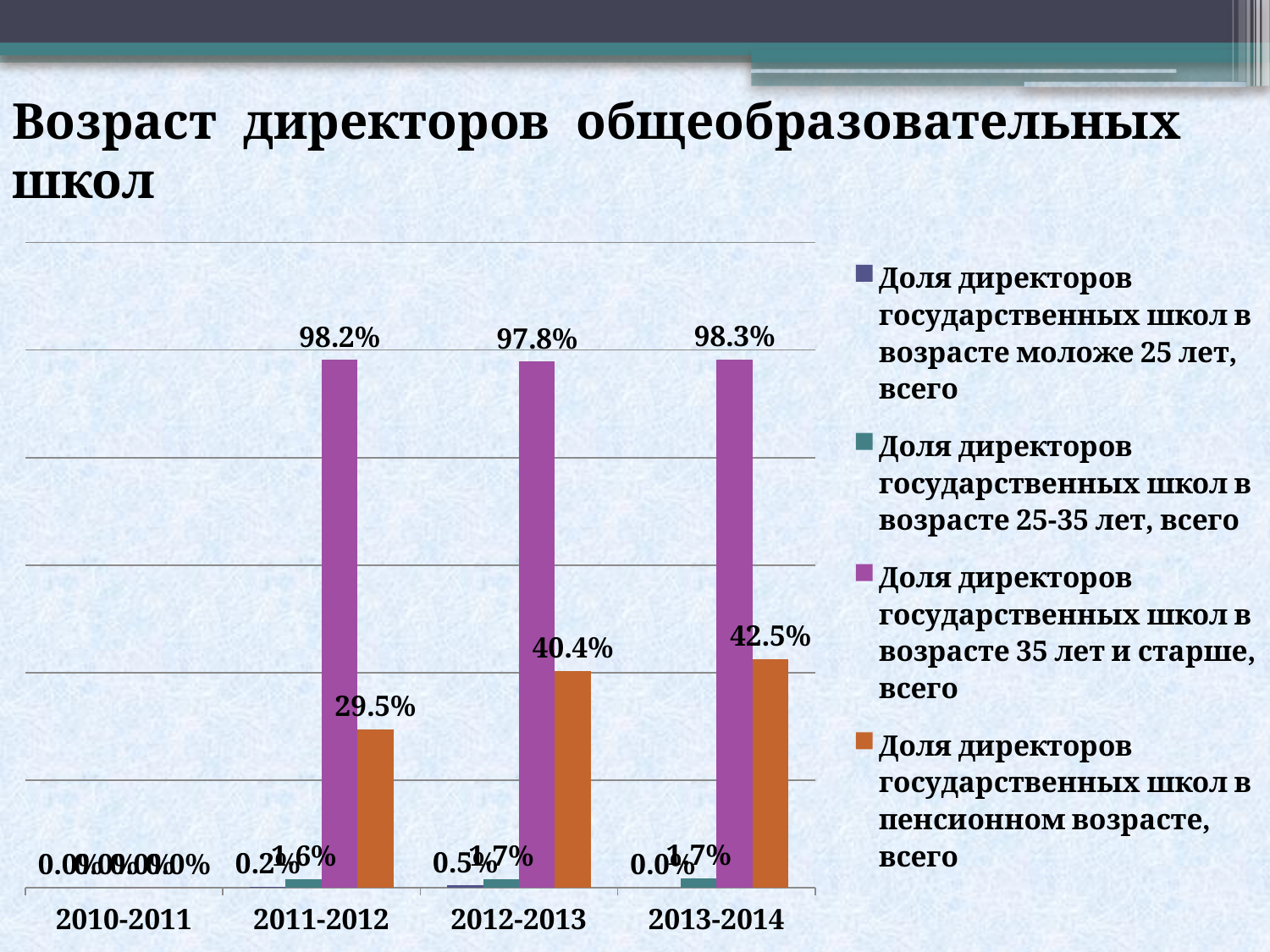
How many year categories are shown on the x axis? 4 How many series does the legend list? 4 What is the value for directors aged 25-35 in 2011-2012? 1.6% What is the value for directors of pension age in 2012-2013? 40.4% What type of chart is shown on the slide? bar chart Does the value for directors of pension age rise or fall from 2011-2012 to 2013-2014? rise In which year is the value for directors aged 35 and older the lowest among 2011-2012, 2012-2013 and 2013-2014? 2012-2013 What is the value for directors aged 35 and older (Доля директоров государственных школ в возрасте 35 лет и старше) in 2011-2012? 98.2% What is the difference between the pension-age values for 2013-2014 and 2011-2012? 13.0% In which year is the value for directors of pension age the highest? 2013-2014 Which colour represents directors aged 35 and older in the legend? purple What is the value for directors of pension age (Доля директоров государственных школ в пенсионном возрасте) in 2013-2014? 42.5%